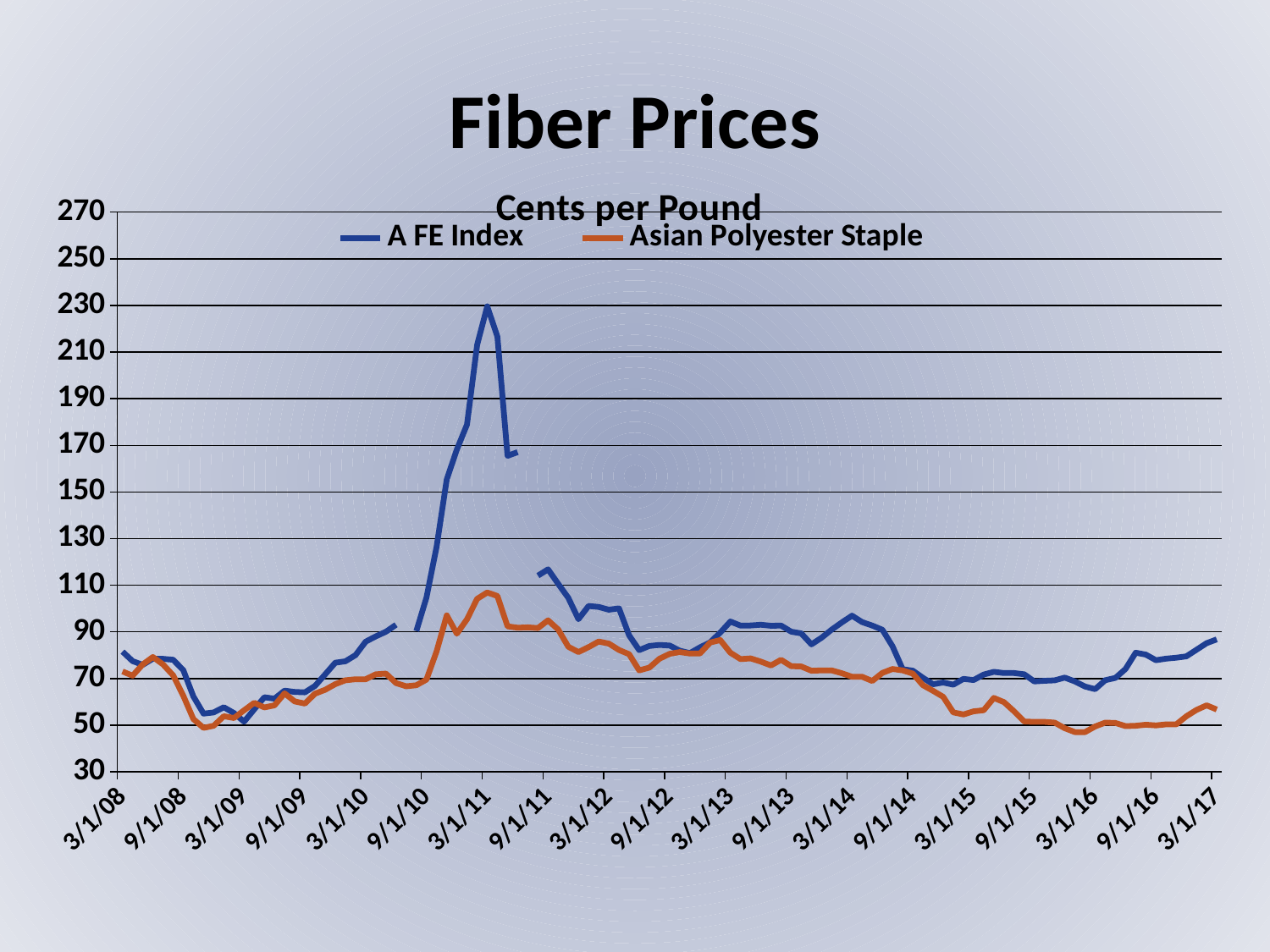
What kind of chart is shown on the slide? line chart Which series reaches the highest value on the chart? A FE Index What is the title of the chart? Cents per Pound At 3/1/17, which series has the higher value, A FE Index or Asian Polyester Staple? A FE Index Is the value for Asian Polyester Staple at 3/1/17 greater or less than 70? less Is the value for A FE Index at 3/1/17 greater or less than 70? greater How many series does the legend list? 2 What unit is given in the chart subtitle? Cents per Pound Is the peak value of the A FE Index around 3/1/11 greater or less than 210? greater Does Asian Polyester Staple rise or fall between 3/1/14 and 3/1/16? fall Does the A FE Index rise or fall between 9/1/10 and 3/1/11? rise